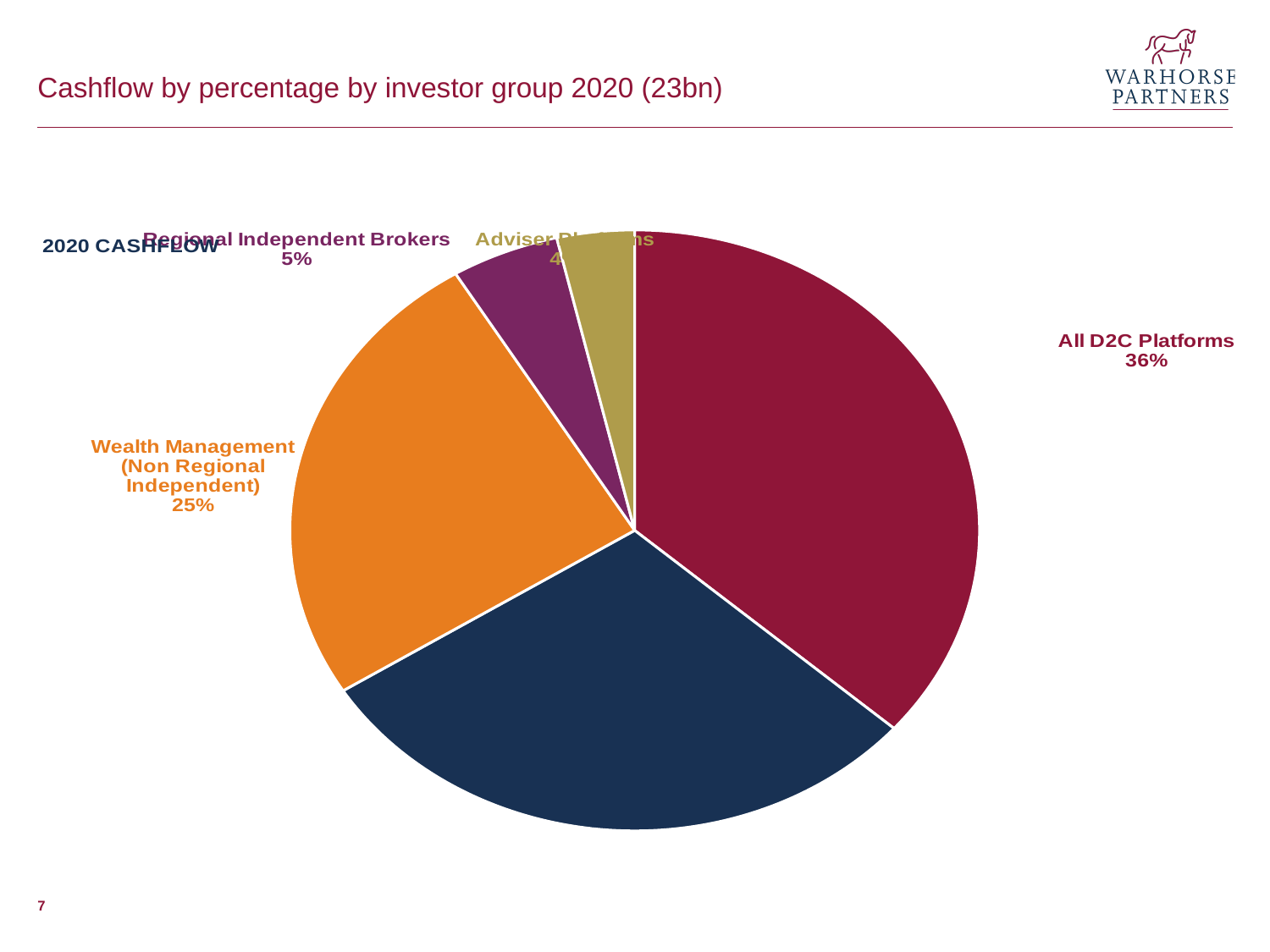
Which is larger: the share for Wealth Management (Non Regional Independent) or the share for Regional Independent Brokers? Wealth Management (Non Regional Independent) What is the title of the slide? Cashflow by percentage by investor group 2020 (23bn) How many percentage points larger is the Wealth Management (Non Regional Independent) share than the Regional Independent Brokers share? 20 percentage points How many percentage points larger is the All D2C Platforms share than the Wealth Management (Non Regional Independent) share? 11 percentage points What is the title of the pie chart? 2020 CASHFLOW What kind of chart is shown on the slide? Pie chart Which investor group has the largest share of the pie? All D2C Platforms What percentage of 2020 cashflow is attributed to All D2C Platforms? 36% Which is larger: the share for All D2C Platforms or the share for Wealth Management (Non Regional Independent)? All D2C Platforms What percentage of 2020 cashflow is attributed to Regional Independent Brokers? 5% How many slices does the pie chart have? 5 What percentage of 2020 cashflow is attributed to Wealth Management (Non Regional Independent)? 25%